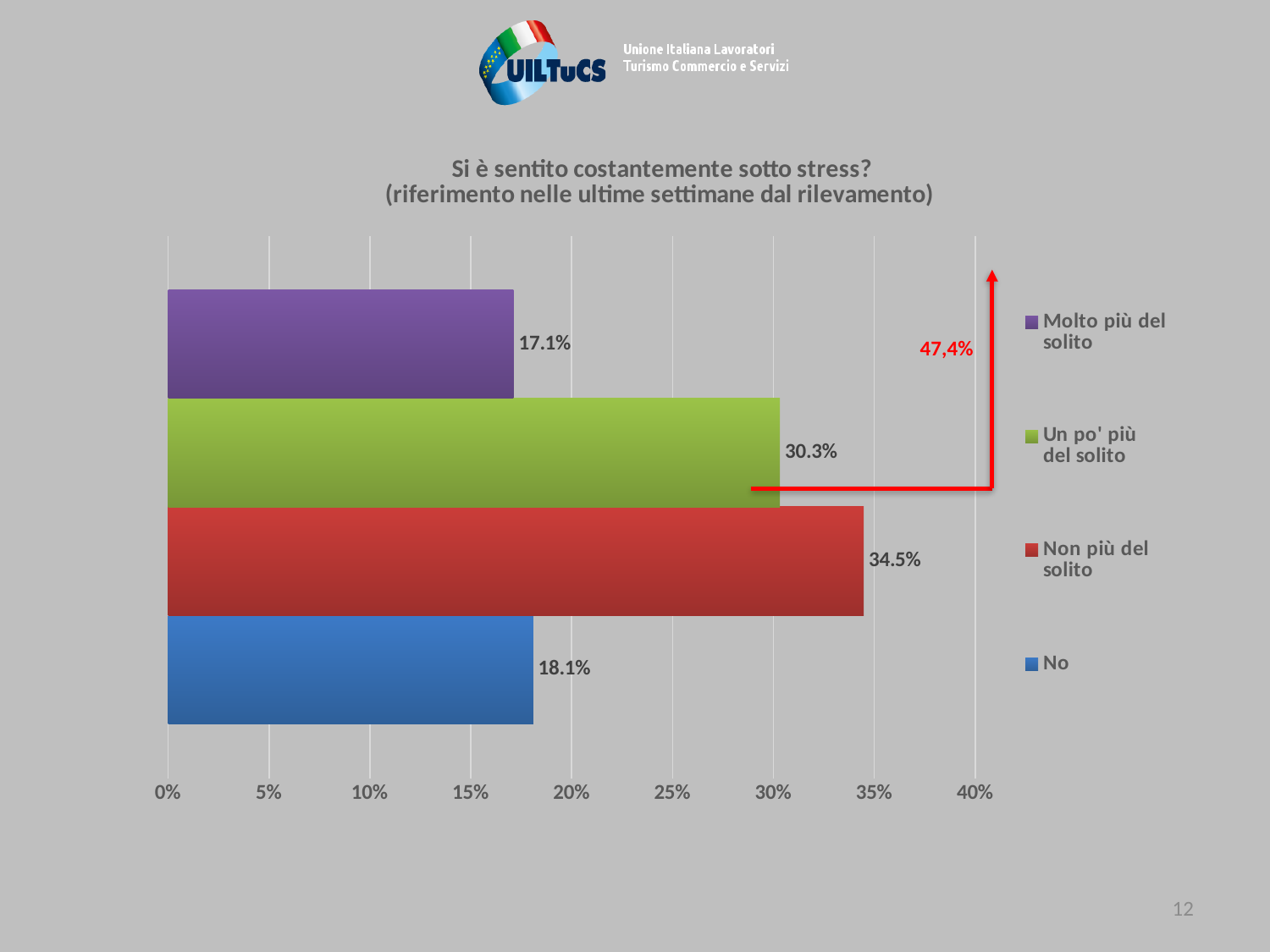
What is the value for "Molto più del solito"? 17.1% What is the value for "No"? 18.1% What kind of chart is shown on the slide? bar chart What is the value for "Un po' più del solito"? 30.3% What percentage is written in red next to the arrow annotation on the chart? 47,4% Which is larger, the value for "No" or the value for "Molto più del solito"? No Which category has the lowest value? Molto più del solito What is the value for "Non più del solito"? 34.5% Is the value for "Un po' più del solito" greater or less than 25%? greater What is the difference between the values for "Non più del solito" and "Un po' più del solito"? 4.2% How many categories are shown in the chart? 4 Which category has the highest value? Non più del solito